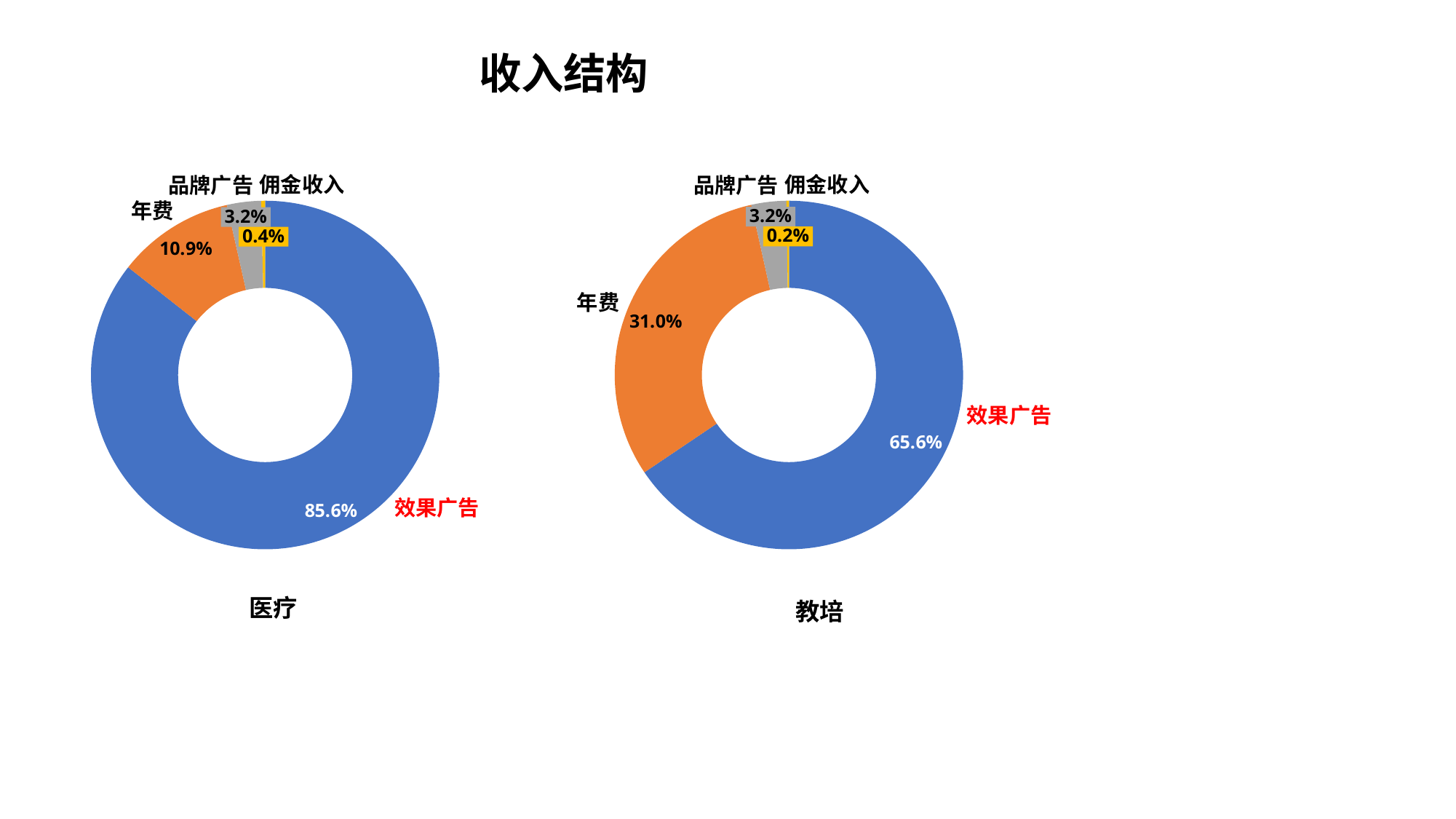
In the 教培 chart, what is the difference between 效果广告 and 年费? 34.6% In the 医疗 chart, what share does 效果广告 have? 85.6% In the 教培 chart, what share does 年费 have? 31.0% In the 教培 chart, which category has the largest share? 效果广告 In the 医疗 chart, what is the value for 年费? 10.9% What is the difference between the 效果广告 share in the 医疗 chart and the 效果广告 share in the 教培 chart? 20.0% How many categories does the 医疗 chart show? 4 Which is larger: 年费 in the 医疗 chart or 年费 in the 教培 chart? 年费 in the 教培 chart In the 教培 chart, what is the value for 佣金收入? 0.2% What is the title of the slide? 收入结构 In the 医疗 chart, which category has the smallest share? 佣金收入 What type of chart is used for 教培? Doughnut (pie) chart